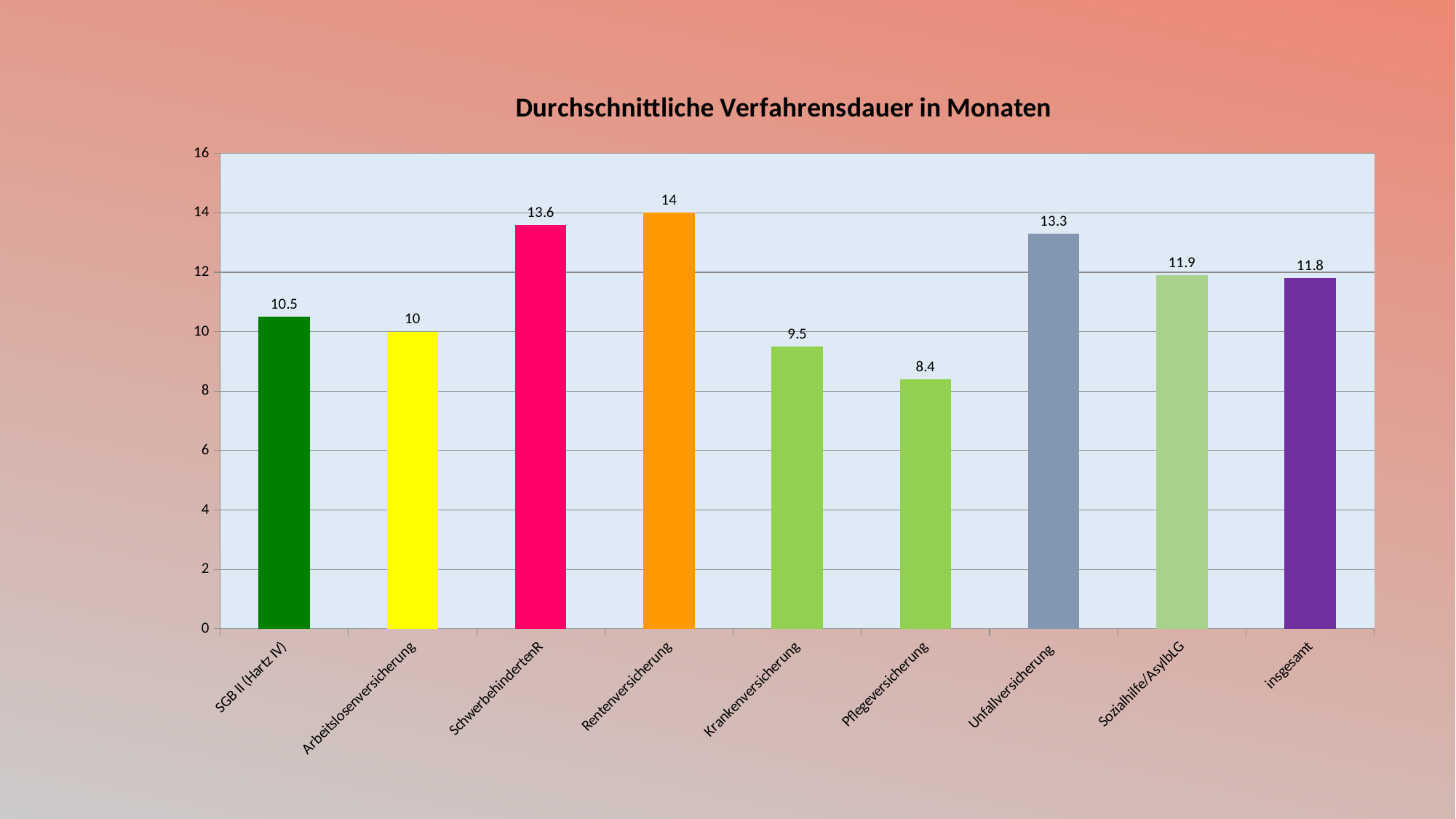
What is the value for Sozialhilfe/AsylbLG? 11.9 Which category has the highest value? Rentenversicherung Which is larger, the value for SGB II (Hartz IV) or the value for Krankenversicherung? SGB II (Hartz IV) Which category has the lowest value? Pflegeversicherung What is the difference between the values for Rentenversicherung and Pflegeversicherung? 5.6 What is the value for insgesamt? 11.8 What is the value for Pflegeversicherung? 8.4 What kind of chart is shown on the slide? bar chart What is the title of the chart? Durchschnittliche Verfahrensdauer in Monaten How many categories are shown on the x axis? 9 What is the difference between the values for SchwerbehindertenR and Unfallversicherung? 0.3 What is the value for Rentenversicherung? 14